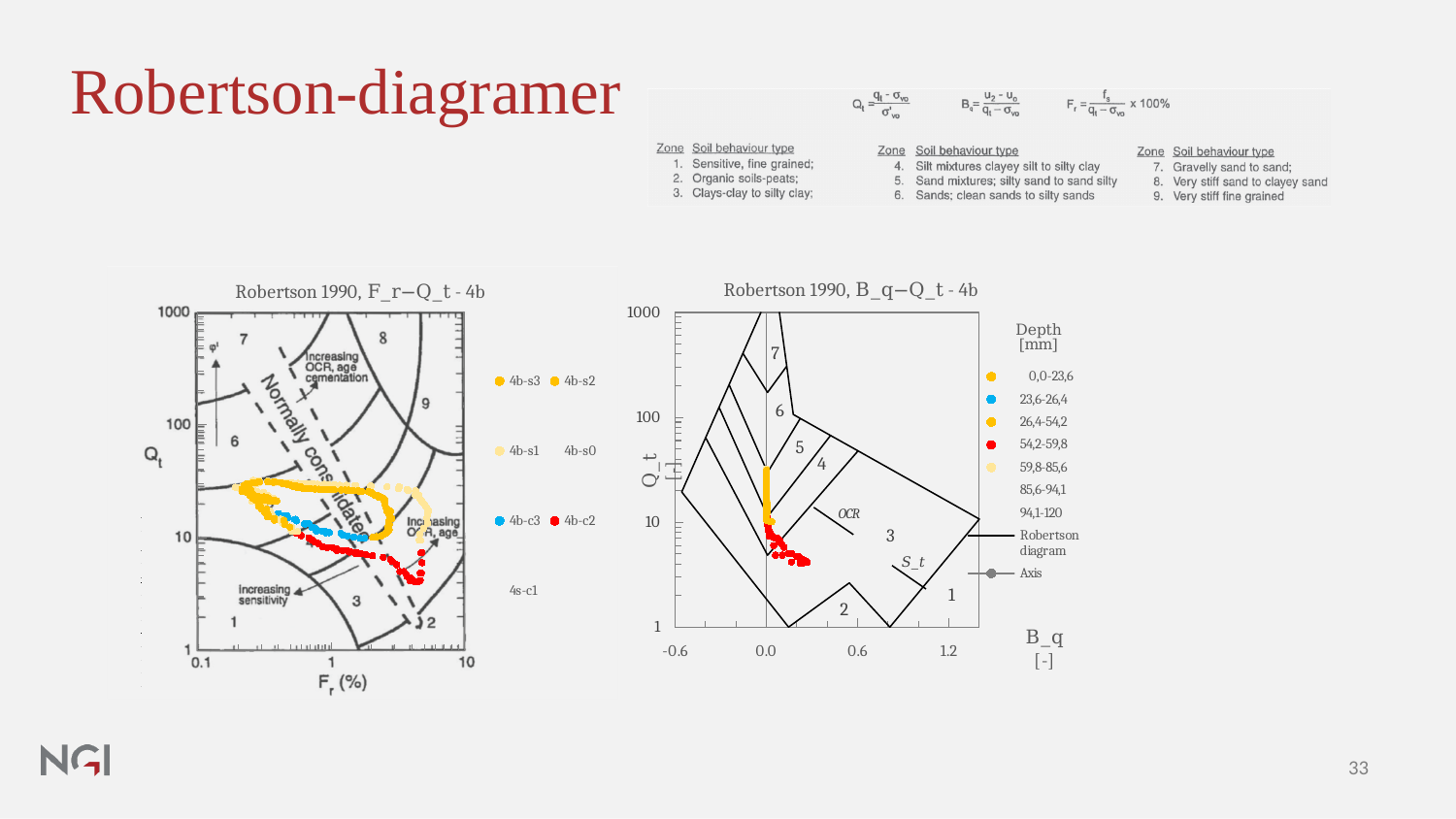
In the 'Robertson 1990, F_r–Q_t - 4b' chart, how many series does the legend list? 7 In the 'Robertson 1990, F_r–Q_t - 4b' chart, are the Q_t values of the plotted points greater or less than 100? less How many numbered soil behaviour zones are shown in the 'Robertson 1990, B_q–Q_t - 4b' chart? 7 What kind of chart is the 'Robertson 1990, F_r–Q_t - 4b' chart on the left? scatter chart What kind of chart is the 'Robertson 1990, B_q–Q_t - 4b' chart on the right? scatter chart In the 'Robertson 1990, B_q–Q_t - 4b' chart, what is the highest tick value shown on the x axis? 1.2 In the 'Robertson 1990, B_q–Q_t - 4b' chart, how many depth ranges does the legend list? 7 In the 'Robertson 1990, B_q–Q_t - 4b' chart, what is the first depth range listed in the legend? 0,0-23,6 In the 'Robertson 1990, B_q–Q_t - 4b' chart, what is the label of the x axis? B_q [-]